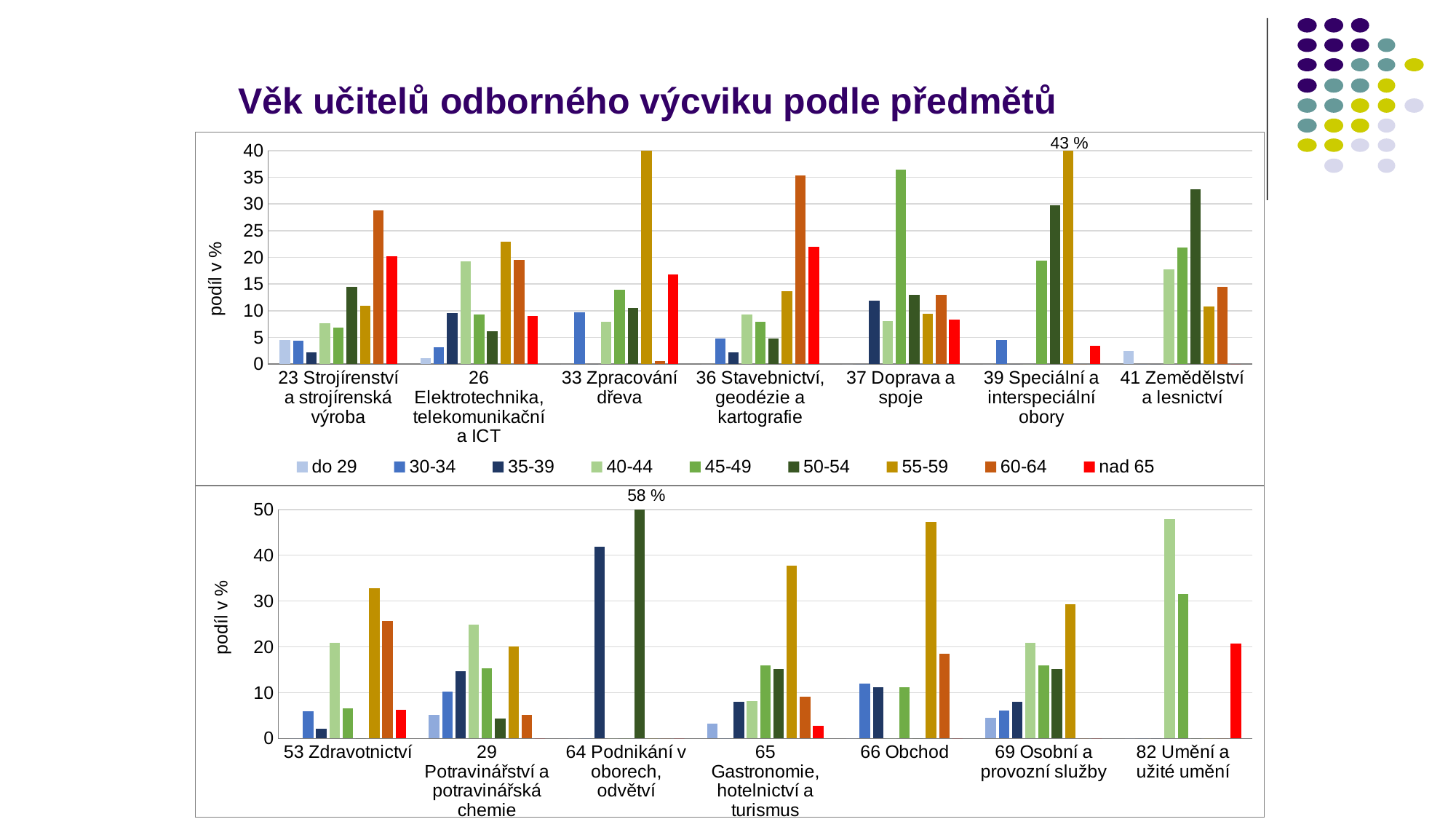
What kind of chart is the top chart on the slide? bar chart In the top chart, what value is labelled for the 55-59 series in the category '39 Speciální a interspeciální obory'? 43 % How many categories (subject groups) are shown on the x axis of the top chart? 7 In the bottom chart, what value is labelled for the 50-54 series in the category '64 Podnikání v oborech, odvětví'? 58 % In the top chart, for '37 Doprava a spoje', which series has the larger value: 40-44 or 35-39? 35-39 In the bottom chart, is the value for the 35-39 series in '64 Podnikání v oborech, odvětví' greater or less than 30? greater In the bottom chart, is the value for the 40-44 series in '82 Umění a užité umění' greater or less than 40? greater In the top chart, is the value for the 60-64 series in '23 Strojírenství a strojírenská výroba' greater or less than 25? greater What is the label on the vertical axis of the charts? podíl v % How many categories (subject groups) are shown on the x axis of the bottom chart? 7 In the bottom chart, which category has the highest value for the 55-59 series? 66 Obchod How many age-group series does the legend list? 9